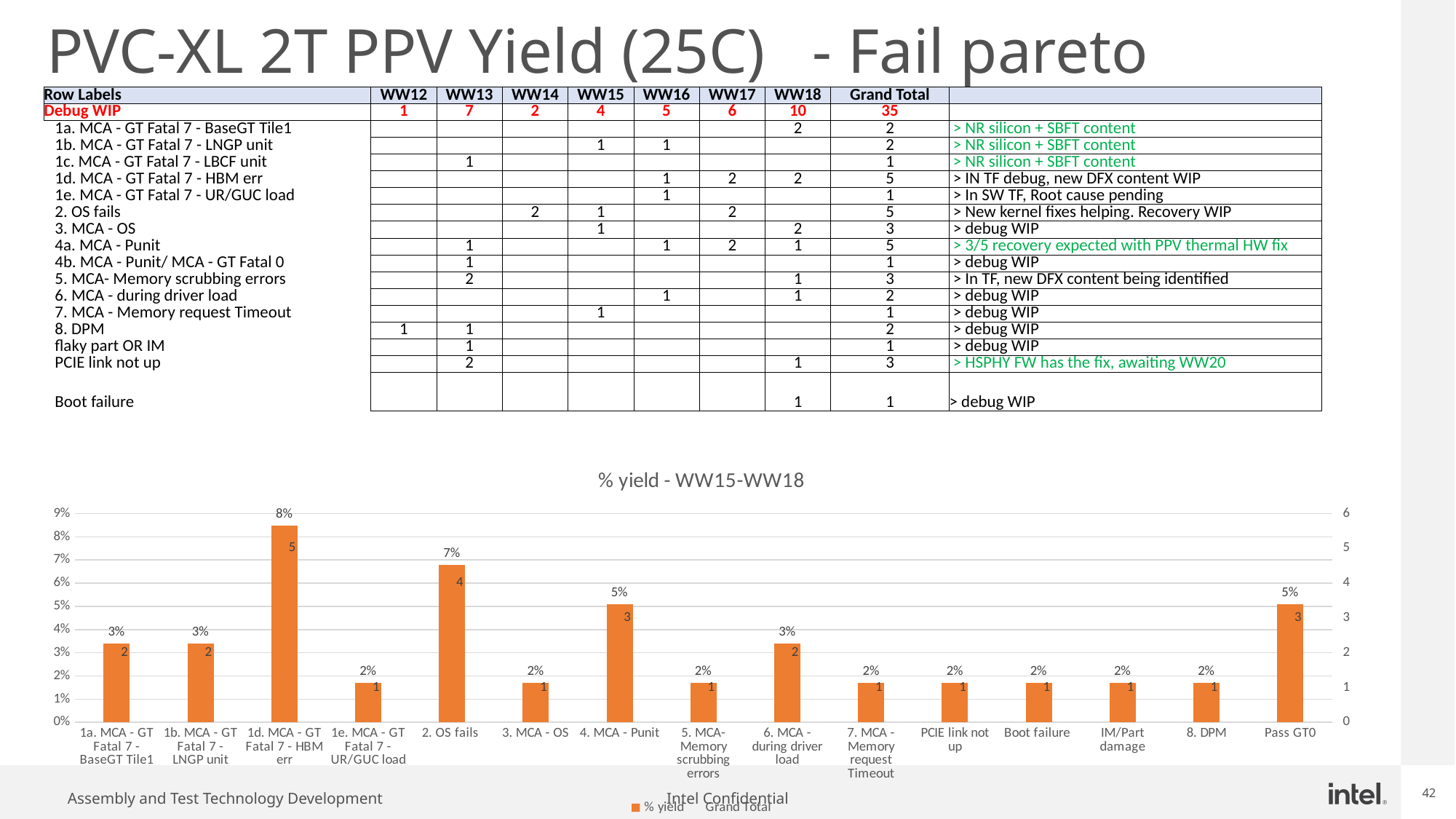
What is the % yield value shown for Pass GT0? 5% Which is larger, the % yield for 2. OS fails or for 4. MCA - Punit? 2. OS fails Which category has the highest % yield in the chart? 1d. MCA - GT Fatal 7 - HBM err What is the % yield value shown for 6. MCA - during driver load? 3% What Grand Total count is shown inside the bar for 1d. MCA - GT Fatal 7 - HBM err? 5 Is the % yield for 1d. MCA - GT Fatal 7 - HBM err greater or less than 6%? greater What type of chart is shown on the slide? bar chart What is the title of the chart? % yield - WW15-WW18 What is the difference between the Grand Total counts for 1d. MCA - GT Fatal 7 - HBM err and 2. OS fails? 1 How many categories are plotted on the x axis of the chart? 15 How many series does the chart legend list? 2 What is the % yield value shown for 2. OS fails? 7%